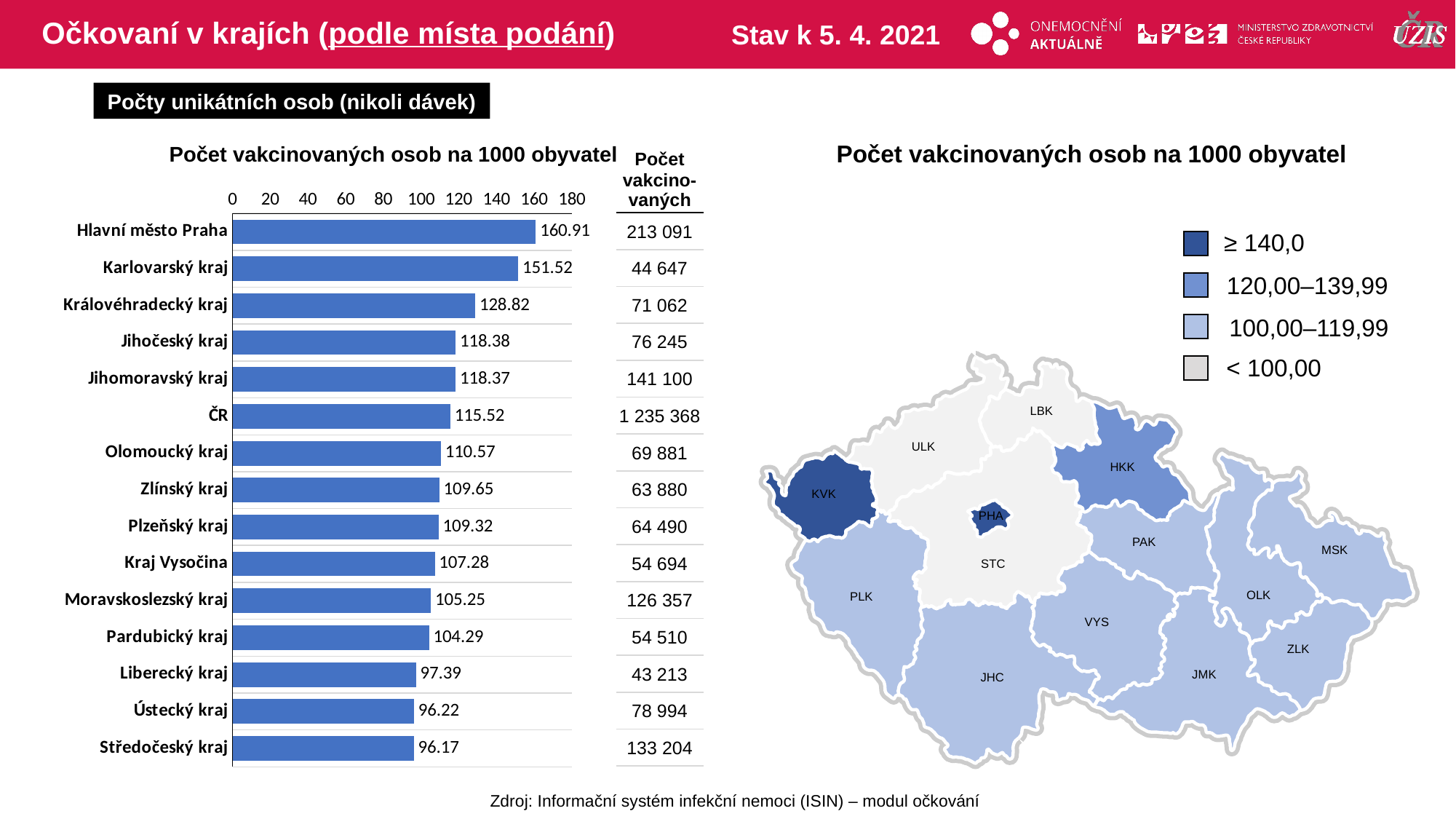
What type of chart is used to show the number of vaccinated persons per 1000 inhabitants by region? bar chart How many colour categories does the legend of the map show? 4 In the bar chart, what is the difference between the values for Hlavní město Praha and Karlovarský kraj? 9.39 In the bar chart, what is the value for Olomoucký kraj? 110.57 Which region has the lowest number of vaccinated persons per 1000 inhabitants in the bar chart? Středočeský kraj In the bar chart, what is the value for Hlavní město Praha? 160.91 In the bar chart, which has a higher value: Královéhradecký kraj or Plzeňský kraj? Královéhradecký kraj How many bars (regions including ČR) are shown in the bar chart? 15 Which region has the highest number of vaccinated persons per 1000 inhabitants in the bar chart? Hlavní město Praha In the bar chart, are the bars ordered from largest to smallest going from top to bottom? Yes In the bar chart, what is the value for ČR? 115.52 In the bar chart, is the value for Liberecký kraj greater or less than 100? less